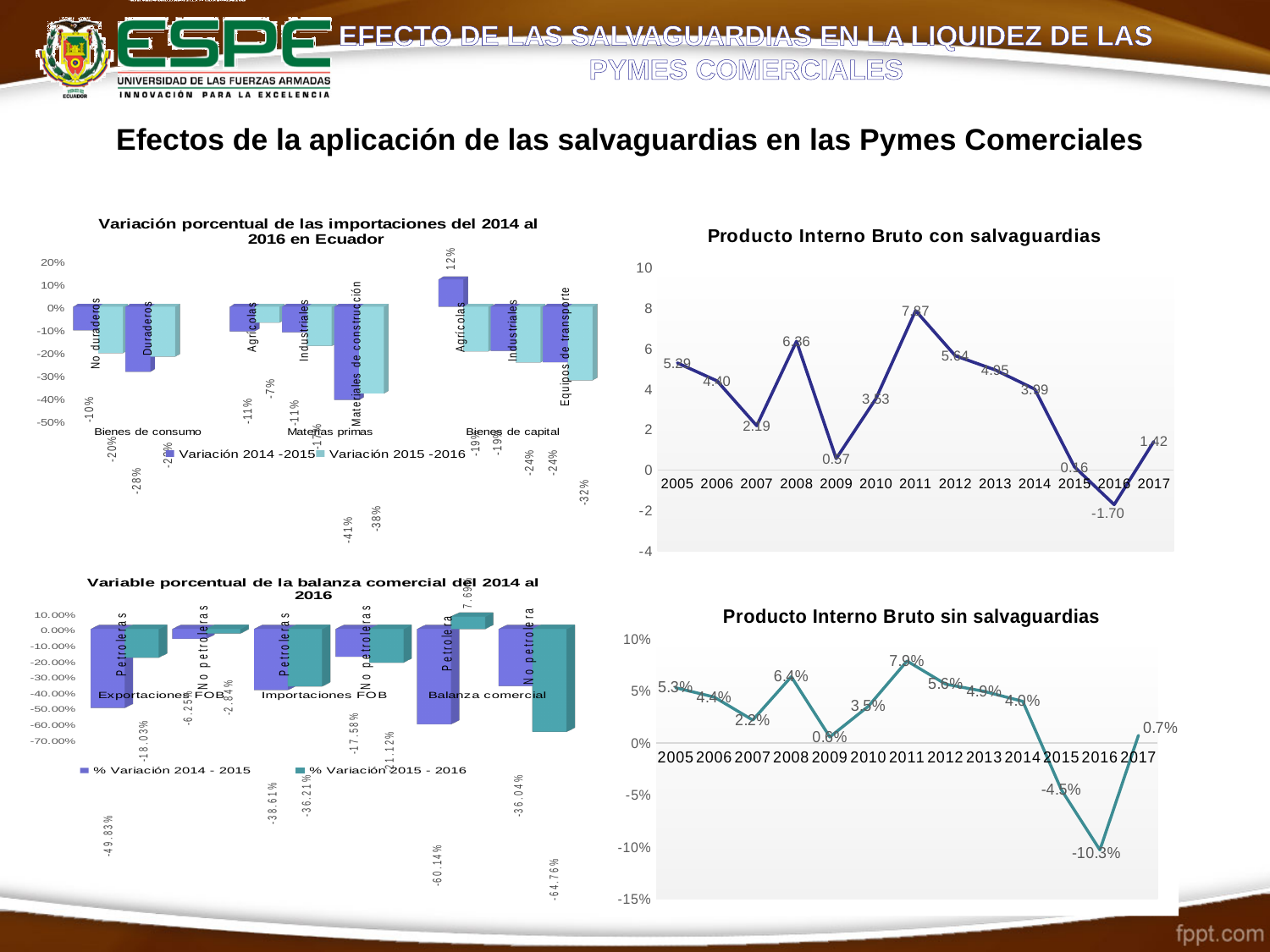
How many series does the legend of the 'Variable porcentual de la balanza comercial del 2014 al 2016' chart list? 2 In the 'Producto Interno Bruto con salvaguardias' chart, what is the value for 2016? -1.70 In the 'Producto Interno Bruto sin salvaguardias' chart, what is the value for 2016? -10.3% In the 'Producto Interno Bruto con salvaguardias' chart, what is the value for 2009? 0.57 What kind of chart is 'Producto Interno Bruto con salvaguardias'? Line chart In the 'Variación porcentual de las importaciones del 2014 al 2016 en Ecuador' chart, what is the Variación 2015 -2016 value for Equipos de transporte? -32% In the 'Variable porcentual de la balanza comercial del 2014 al 2016' chart, what is the % Variación 2014 - 2015 value for Petroleras under Exportaciones FOB? -49.83% In the 'Producto Interno Bruto con salvaguardias' chart, which year has the lowest value? 2016 In the 'Producto Interno Bruto sin salvaguardias' chart, what is the value for 2015? -4.5% In the 'Producto Interno Bruto sin salvaguardias' chart, which year has the highest value? 2011 In the 'Variación porcentual de las importaciones del 2014 al 2016 en Ecuador' chart, what is the Variación 2014 -2015 value for Agrícolas under Bienes de capital? 12% In the 'Variable porcentual de la balanza comercial del 2014 al 2016' chart, what is the % Variación 2015 - 2016 value for No petrolera under Balanza comercial? -64.76%